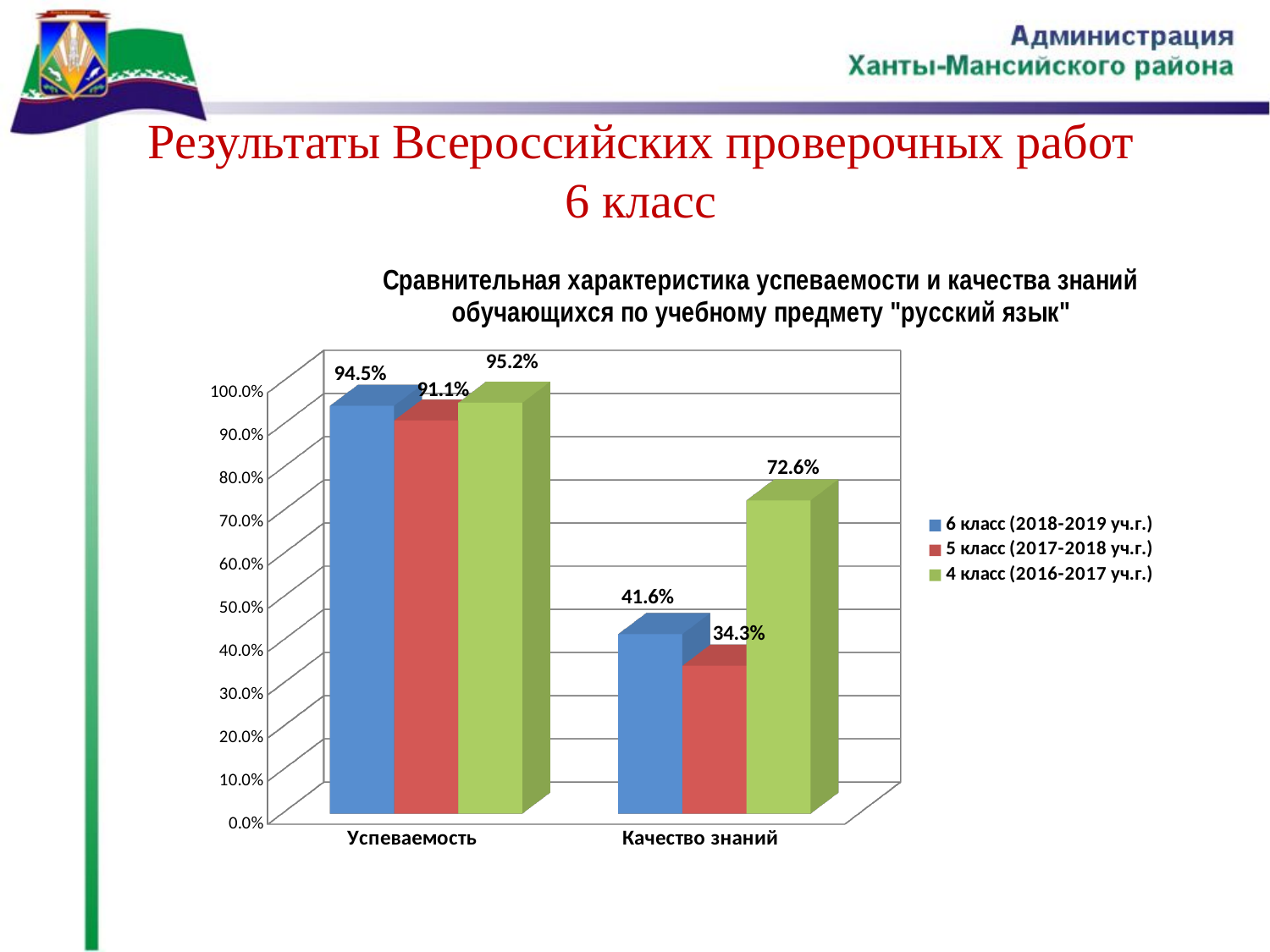
What is the value for 6 класс (2018-2019 уч.г.) in the Успеваемость category? 94.5% Which is larger in the Качество знаний category: the value for 6 класс (2018-2019 уч.г.) or for 5 класс (2017-2018 уч.г.)? 6 класс (2018-2019 уч.г.) Which series has the highest value in the Качество знаний category? 4 класс (2016-2017 уч.г.) What kind of chart is shown on the slide? Bar chart What is the value for 5 класс (2017-2018 уч.г.) in the Успеваемость category? 91.1% Which series has the lowest value in the Успеваемость category? 5 класс (2017-2018 уч.г.) What is the difference between the 6 класс (2018-2019 уч.г.) and 5 класс (2017-2018 уч.г.) values in the Успеваемость category? 3.4% How many series does the legend list? 3 What is the value for 5 класс (2017-2018 уч.г.) in the Качество знаний category? 34.3% What is the difference between the 4 класс (2016-2017 уч.г.) and 5 класс (2017-2018 уч.г.) values in the Качество знаний category? 38.3% What is the value for 4 класс (2016-2017 уч.г.) in the Качество знаний category? 72.6% How many categories are shown on the x axis? 2